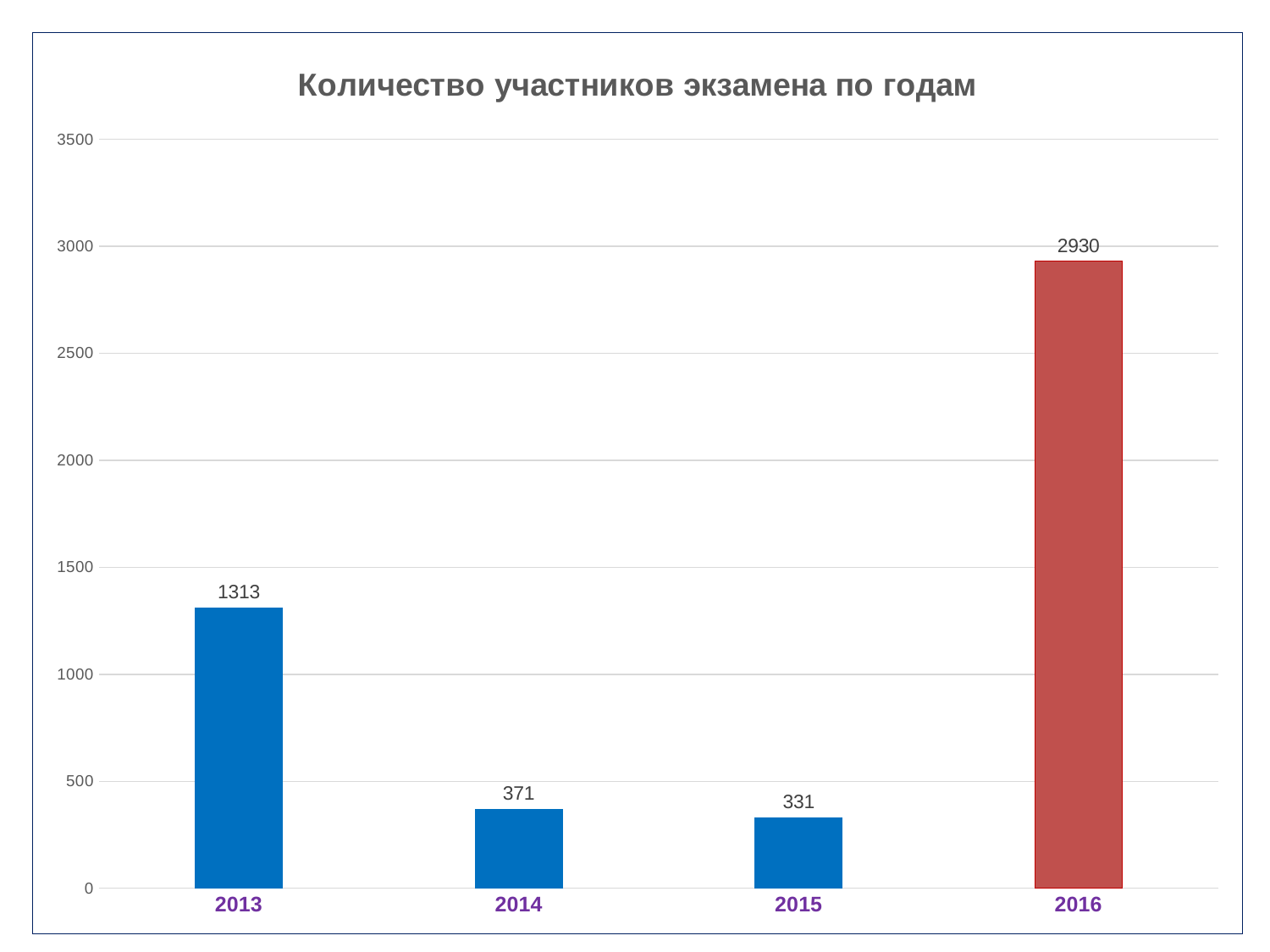
What kind of chart is shown on the slide? bar chart What is the value for 2015? 331 How many years are shown on the x axis? 4 Which is larger, the value for 2013 or the value for 2014? 2013 What is the title of the chart? Количество участников экзамена по годам Which year has the highest value? 2016 What is the value for 2016? 2930 What is the difference between the values for 2014 and 2015? 40 Which year has the lowest value? 2015 What is the value for 2013? 1313 What is the difference between the values for 2016 and 2013? 1617 Is the value for 2016 greater or less than 2500? greater